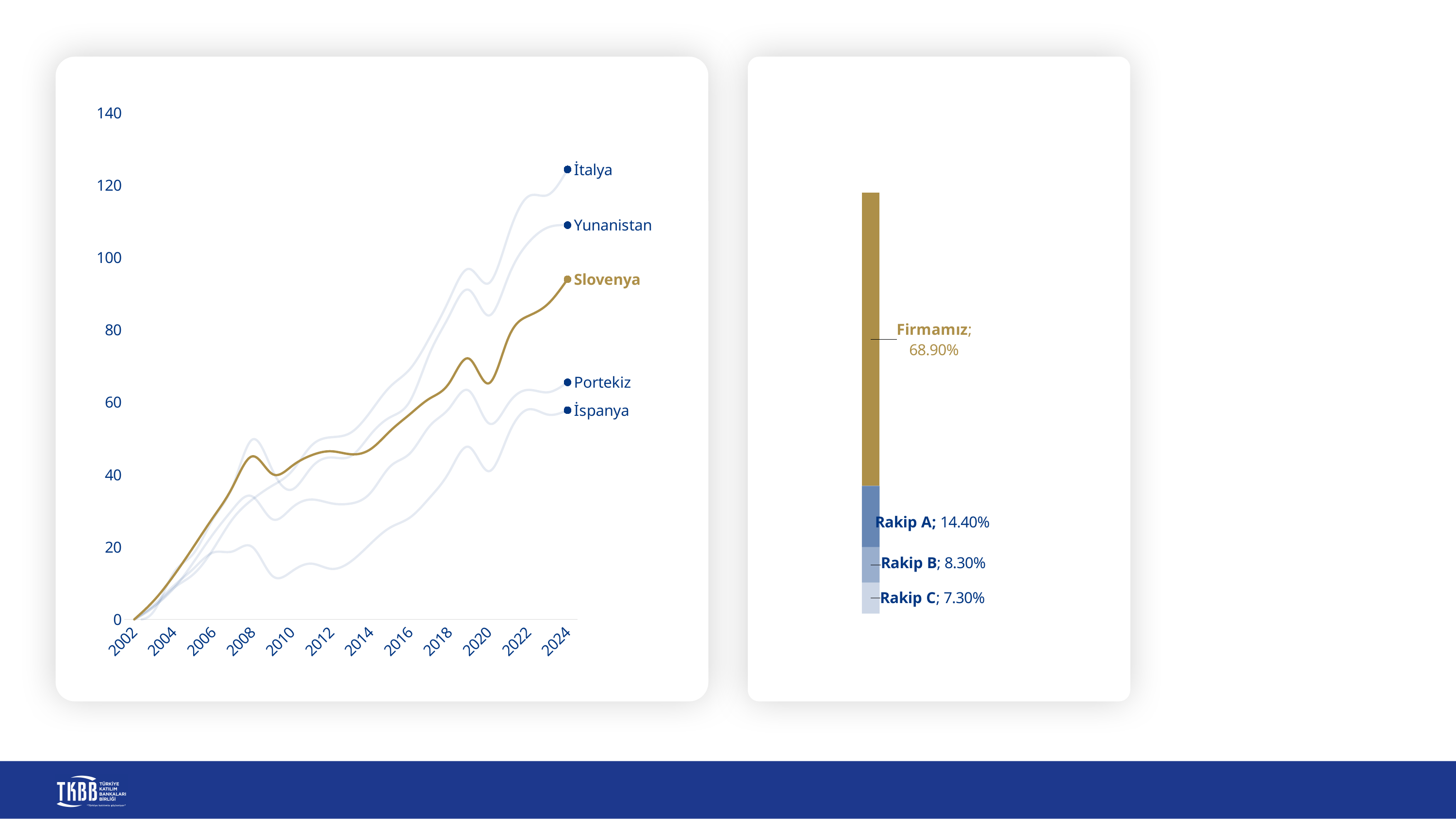
In the chart on the left, is the value for İtalya in 2024 greater or less than 120? greater In the chart on the right, which segment has the smallest value? Rakip C In the chart on the left, is the value for Slovenya in 2024 greater or less than 100? less In the chart on the right, what is the value for Rakip B? 8.30% In the chart on the right, what is the difference between Firmamız and Rakip A? 54.50% What kind of chart is the chart on the left? line chart In the chart on the left, how many series are labelled? 5 In the chart on the left, do the values for Slovenya generally rise or fall from 2002 to 2024? rise In the chart on the left, which series has the lowest value in 2024? İspanya In the chart on the left, which series is drawn in gold and highlighted in bold? Slovenya In the chart on the left, which series has the highest value in 2024? İtalya In the chart on the right, what is the value for Firmamız? 68.90%